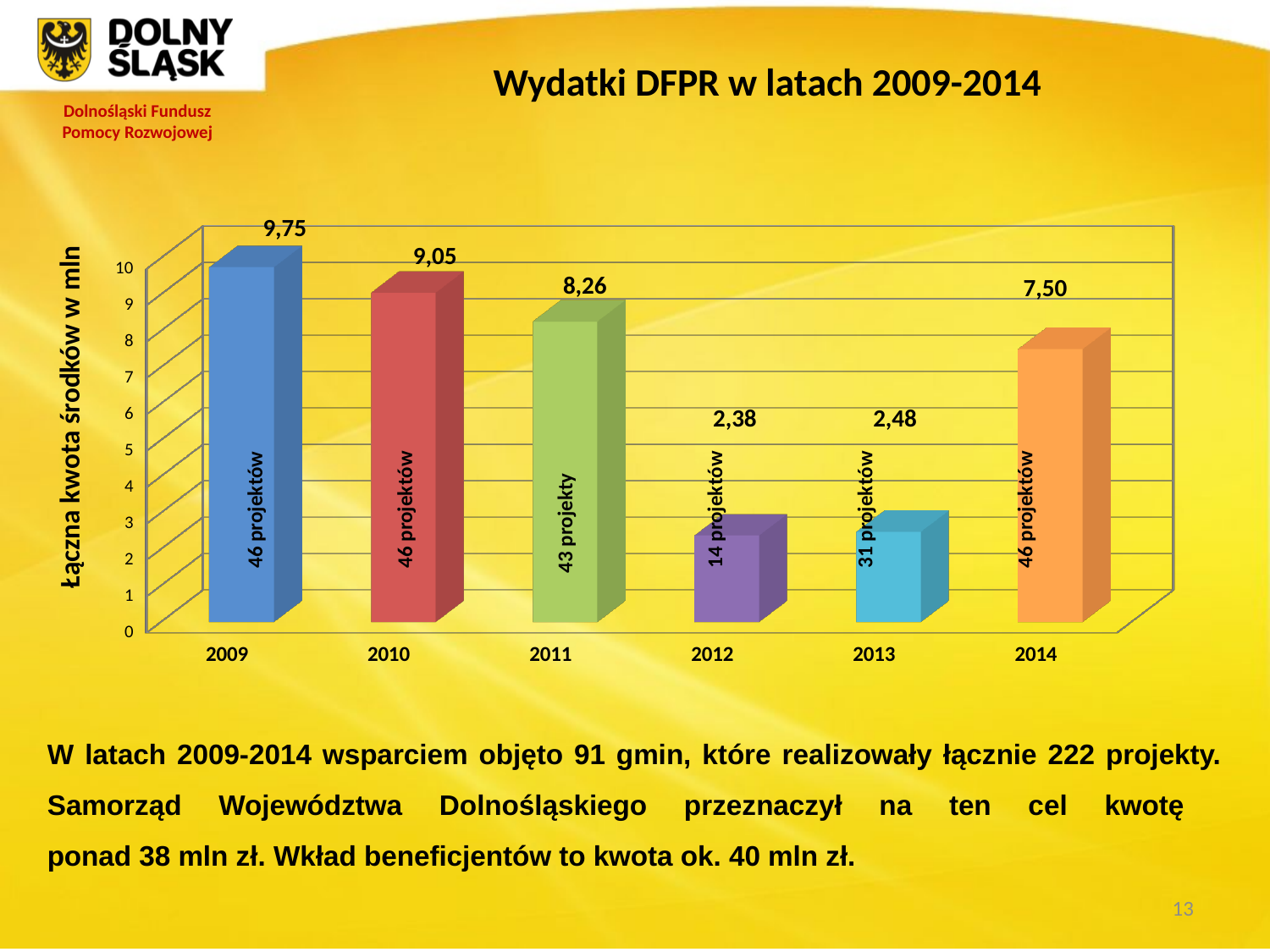
What is the value for 2009? 9,75 What is the difference between the values for 2009 and 2010? 0,70 What is the value for 2012? 2,38 What is the difference between the values for 2011 and 2014? 0,76 How many years are shown on the x axis? 6 Which year has the lowest value? 2012 What is the title of the chart? Wydatki DFPR w latach 2009-2014 Which year has the highest value? 2009 How many projects are labelled on the bar for 2013? 31 projektów What kind of chart is this? bar chart Which is larger, the value for 2011 or the value for 2014? 2011 What is the value for 2014? 7,50